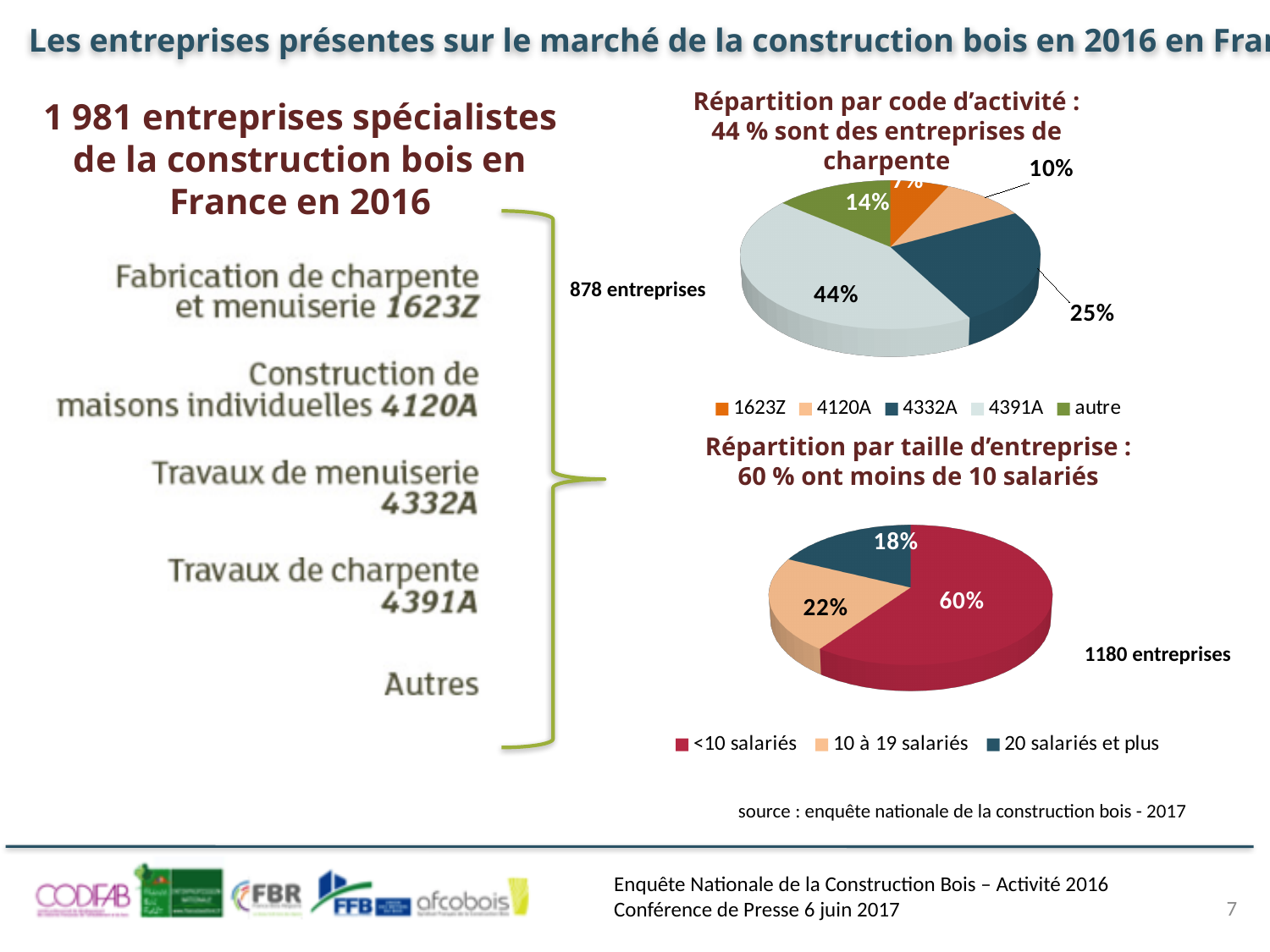
In the pie chart 'Répartition par taille d'entreprise', what is the difference between the shares of '<10 salariés' and '10 à 19 salariés'? 38% In the pie chart 'Répartition par code d'activité', which slice is larger, 4332A or 4120A? 4332A In the pie chart 'Répartition par taille d'entreprise', which category has the smallest slice? 20 salariés et plus In the pie chart 'Répartition par code d'activité', what is the difference between the shares of 4391A and 4332A? 19% In the pie chart 'Répartition par taille d'entreprise', what share is shown for '<10 salariés'? 60% How many categories does the legend of the pie chart 'Répartition par code d'activité' list? 5 In the pie chart 'Répartition par code d'activité', what share is shown for 'autre'? 14% In the pie chart 'Répartition par code d'activité', which activity code has the largest slice? 4391A In the pie chart 'Répartition par code d'activité', what share is shown for 4332A? 25% In the pie chart 'Répartition par taille d'entreprise', what share is shown for '10 à 19 salariés'? 22% What type of chart is used for 'Répartition par taille d'entreprise'? Pie chart In the pie chart 'Répartition par code d'activité', what share is shown for 4391A? 44%